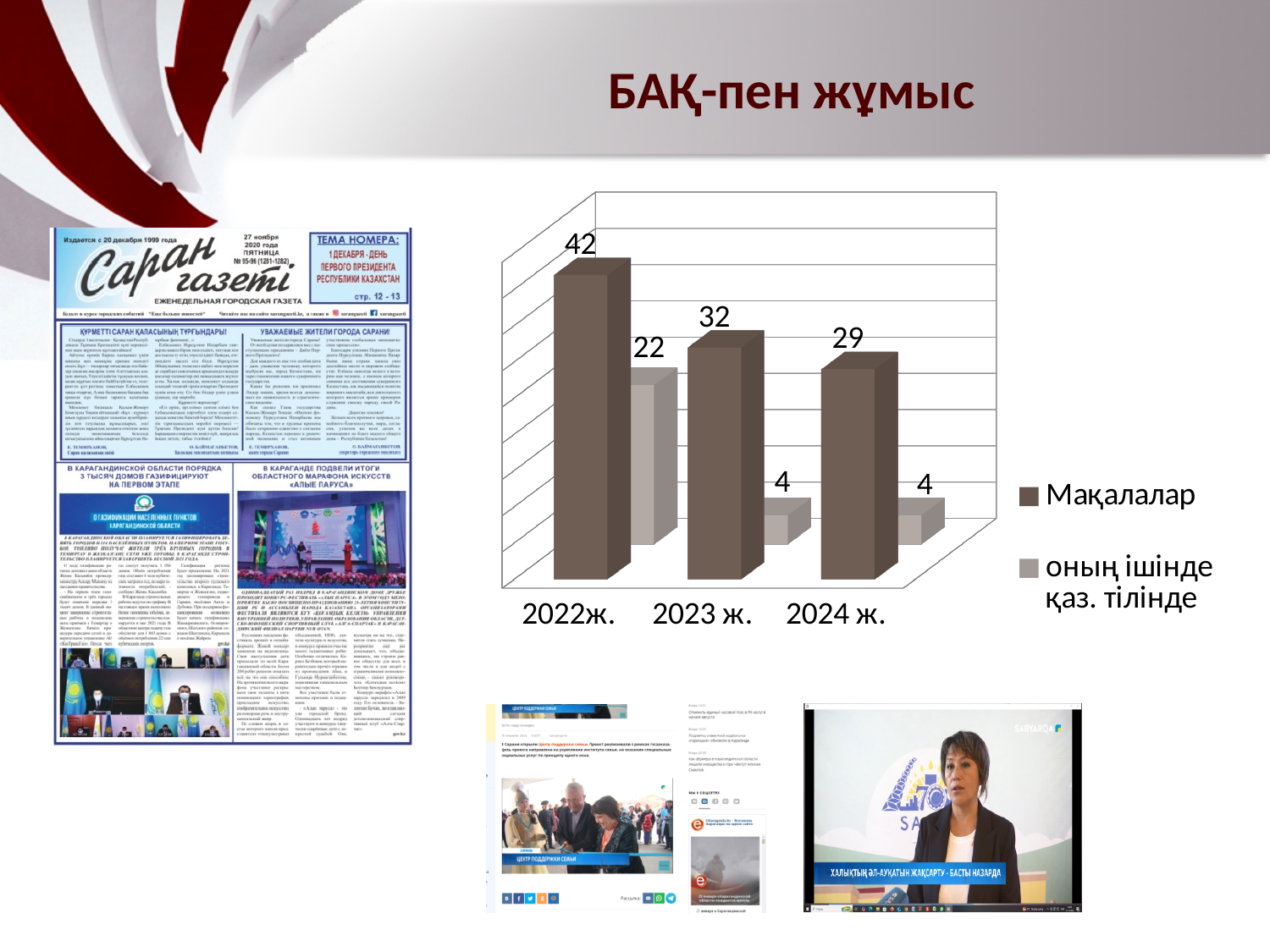
What is the value of оның ішінде қаз. тілінде for 2023 ж.? 4 Which year has the highest value for Мақалалар? 2022ж. What is the value of Мақалалар for 2024 ж.? 29 Which year has the lowest value for Мақалалар? 2024 ж. What is the difference between the Мақалалар values for 2022ж. and 2023 ж.? 10 What is the difference between the Мақалалар and оның ішінде қаз. тілінде values for 2024 ж.? 25 How many series does the chart legend list? 2 What is the value of Мақалалар for 2022ж.? 42 How many years are shown on the x axis of the chart? 3 What is the value of оның ішінде қаз. тілінде for 2022ж.? 22 Which is larger: Мақалалар for 2023 ж. or Мақалалар for 2024 ж.? Мақалалар for 2023 ж. Does the Мақалалар series rise or fall from 2022ж. to 2024 ж.? fall